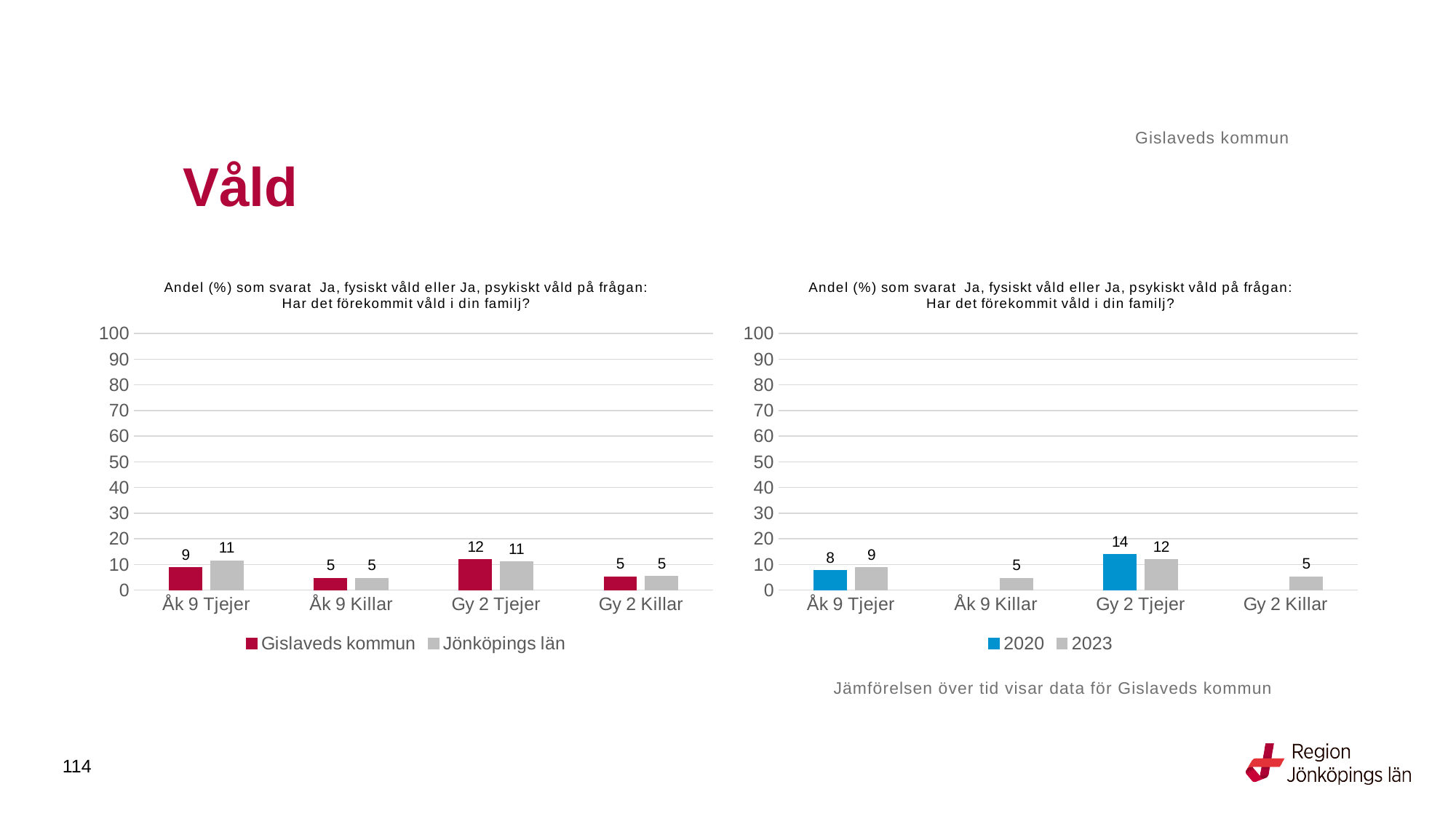
In the left chart, what is the value for Jönköpings län for Åk 9 Tjejer? 11 In the left chart, what is the difference between Jönköpings län and Gislaveds kommun for Åk 9 Tjejer? 2 In the right chart, how many categories are shown on the x axis? 4 In the right chart, what is the value for 2023 for Åk 9 Killar? 5 In the left chart, how many series does the legend list? 2 What kind of chart is the right chart? Bar chart In the right chart, which is larger for Åk 9 Tjejer, 2020 or 2023? 2023 In the left chart, which category has the highest value for Gislaveds kommun? Gy 2 Tjejer In the right chart, what is the value for 2020 for Gy 2 Tjejer? 14 In the right chart, what is the difference between 2020 and 2023 for Gy 2 Tjejer? 2 In the left chart, what is the value for Gislaveds kommun for Gy 2 Tjejer? 12 In the right chart, which two years does the legend list? 2020 and 2023